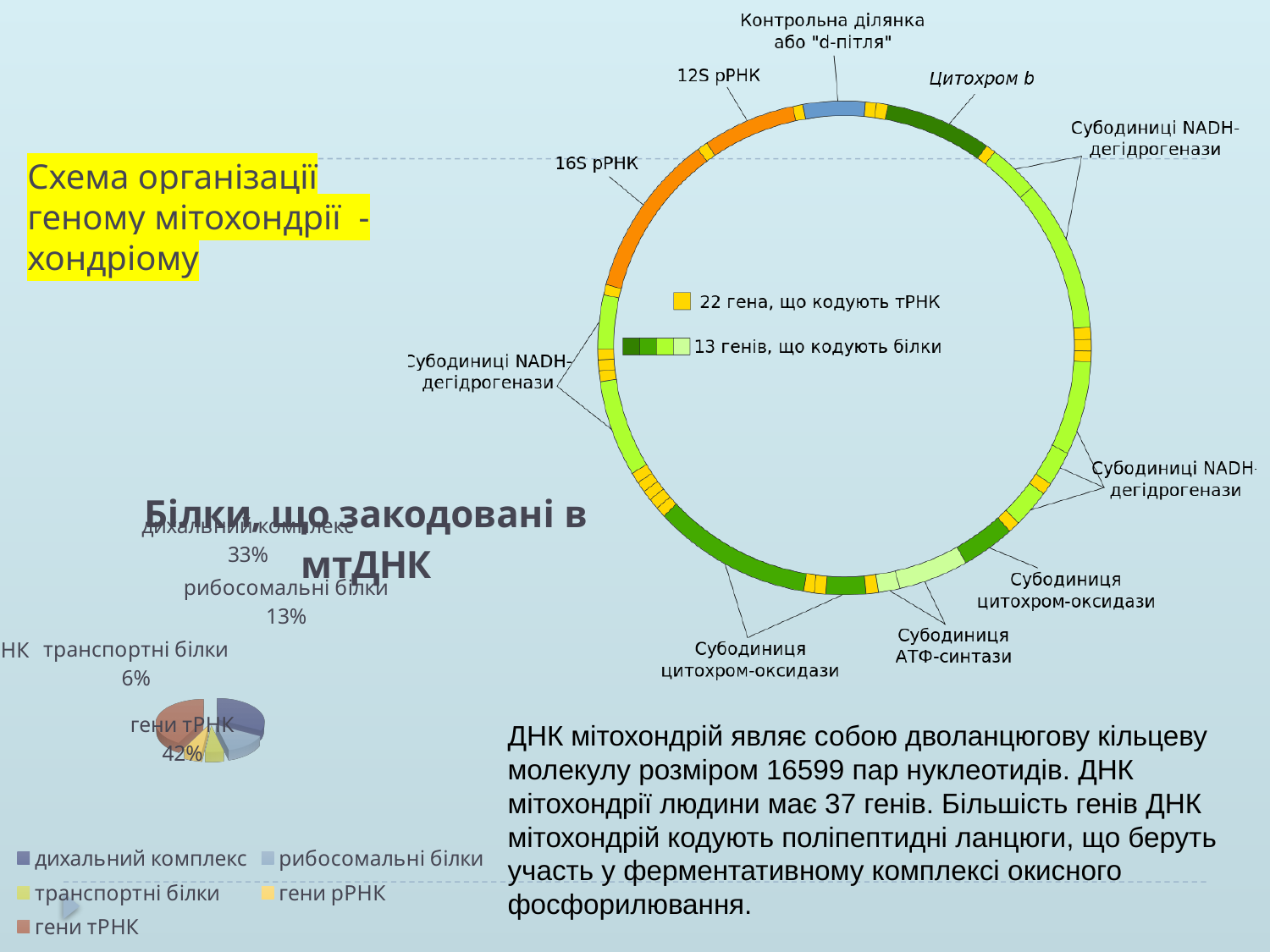
In the pie chart "Білки, що закодовані в мтДНК", what share is shown for дихальний комплекс? 33% In the pie chart "Білки, що закодовані в мтДНК", what is the difference in percentage points between гени тРНК and дихальний комплекс? 9% In the pie chart "Білки, що закодовані в мтДНК", which is larger: дихальний комплекс or рибосомальні білки? дихальний комплекс What kind of chart is "Білки, що закодовані в мтДНК"? pie chart In the pie chart "Білки, що закодовані в мтДНК", what share is shown for гени тРНК? 42% What is the title of the pie chart on the lower left of the slide? Білки, що закодовані в мтДНК In the pie chart "Білки, що закодовані в мтДНК", which is larger: гени тРНК or транспортні білки? гени тРНК In the pie chart "Білки, що закодовані в мтДНК", what is the difference in percentage points between дихальний комплекс and рибосомальні білки? 20% In the pie chart "Білки, що закодовані в мтДНК", which category has the largest share? гени тРНК How many categories does the legend of the pie chart "Білки, що закодовані в мтДНК" list? 5 In the pie chart "Білки, що закодовані в мтДНК", what share is shown for транспортні білки? 6% In the pie chart "Білки, що закодовані в мтДНК", what share is shown for рибосомальні білки? 13%